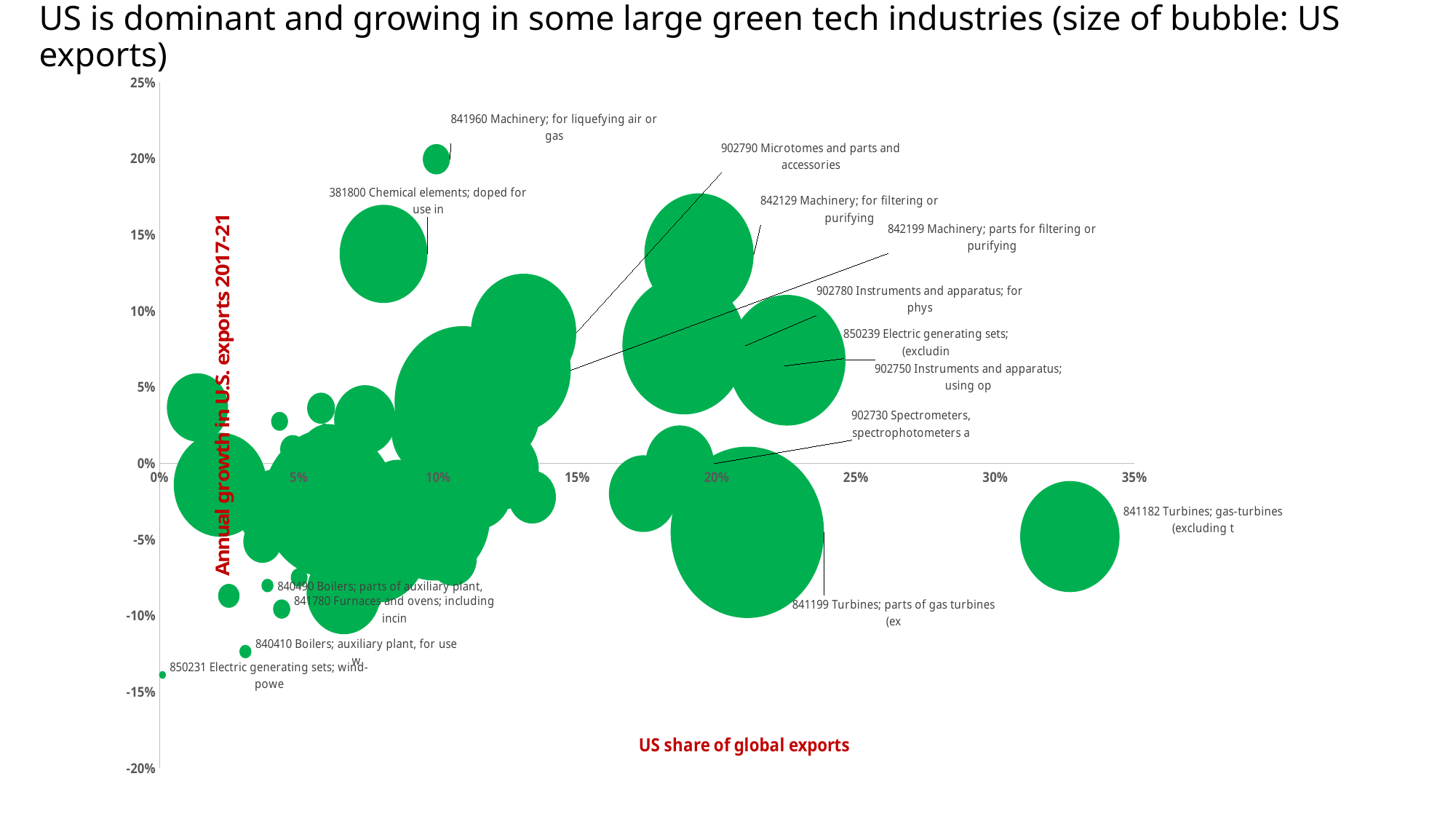
Which labelled product has the lowest annual growth in U.S. exports 2017-21? 850231 Electric generating sets; wind-powe Is the US share of global exports for 841182 Turbines; gas-turbines greater or less than 30%? greater Is the annual growth for 381800 Chemical elements; doped for use in greater or less than 10%? greater Which labelled product has the highest annual growth in U.S. exports 2017-21? 841960 Machinery; for liquefying air or gas Is the annual growth for 841182 Turbines; gas-turbines greater or less than 0%? less Which has a larger US share of global exports: 841182 Turbines; gas-turbines or 841199 Turbines; parts of gas turbines? 841182 Turbines; gas-turbines Which labelled product has the highest US share of global exports? 841182 Turbines; gas-turbines (excluding t What is the label of the horizontal axis? US share of global exports What kind of chart is shown on the slide? Bubble chart What does the size of each bubble represent, according to the slide title? US exports